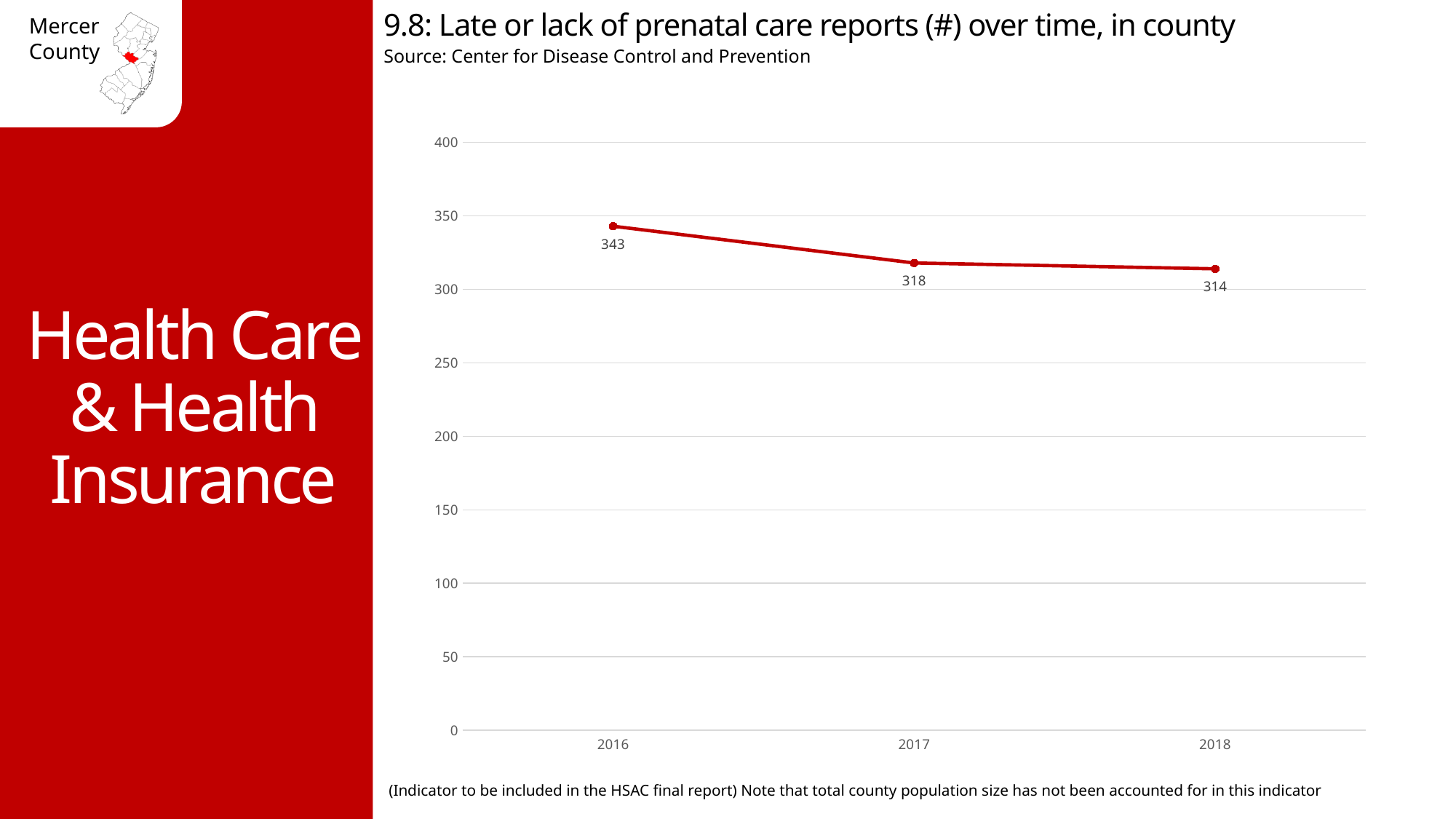
Do the values rise or fall from 2016 to 2018? fall How many years are plotted on the chart? 3 Which year has the lowest number of late or lack of prenatal care reports? 2018 What is the difference between the number of reports in 2016 and 2017? 25 What is the number of late or lack of prenatal care reports in 2017? 318 Which year has more late or lack of prenatal care reports, 2016 or 2018? 2016 Is the value for 2017 greater or less than 350? less What is the number of late or lack of prenatal care reports in 2018? 314 What is the number of late or lack of prenatal care reports in 2016? 343 Which year has the highest number of late or lack of prenatal care reports? 2016 What is the difference between the number of reports in 2016 and 2018? 29 What kind of chart is shown on the slide? line chart